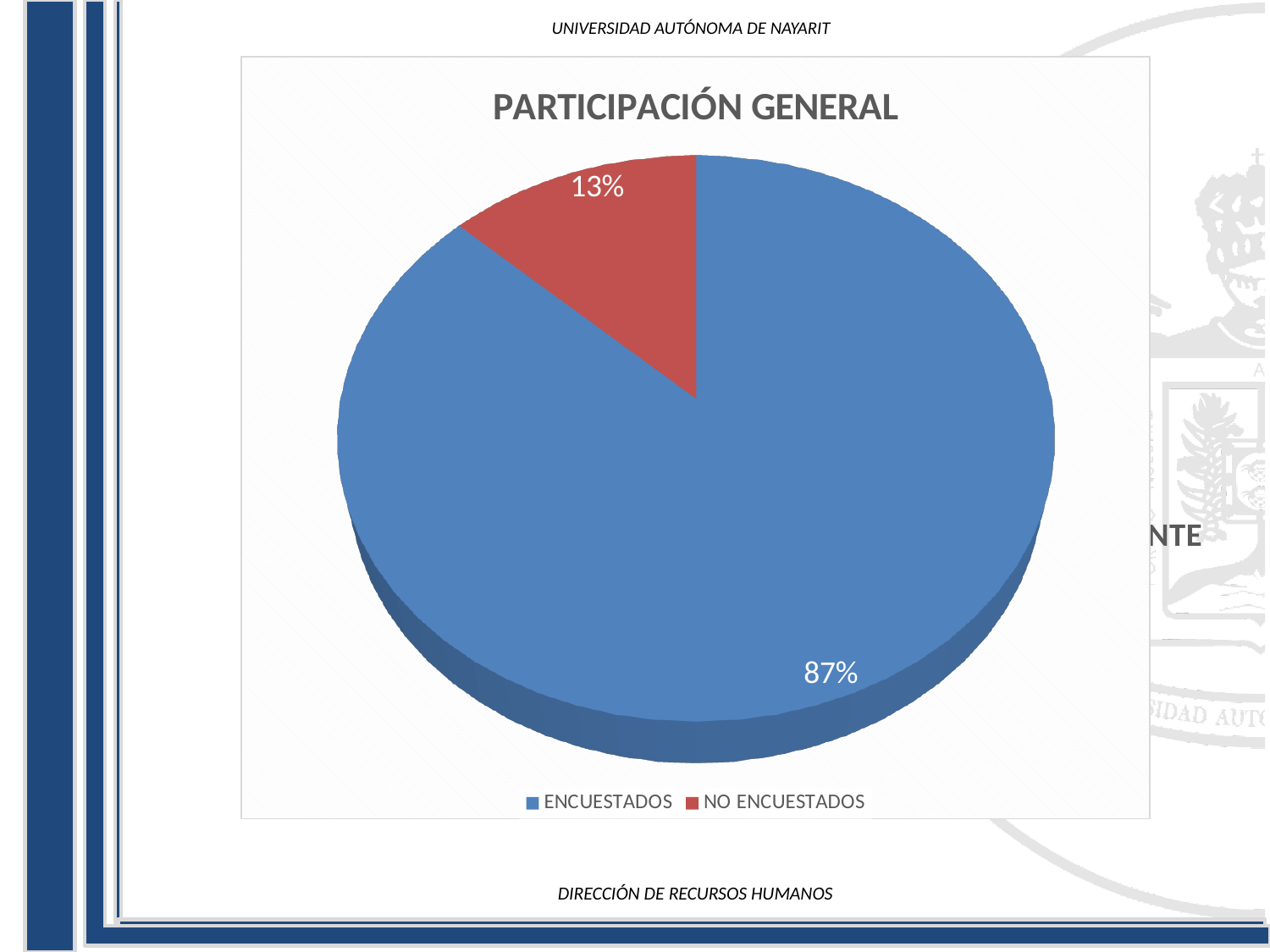
What is the title of the chart? PARTICIPACIÓN GENERAL What colour is the NO ENCUESTADOS slice? red What share of the pie does ENCUESTADOS represent? 87% Which category has the largest slice of the pie? ENCUESTADOS What is the difference in percentage points between ENCUESTADOS and NO ENCUESTADOS? 74 Which category has the smallest slice of the pie? NO ENCUESTADOS How many entries does the legend list? 2 What kind of chart is shown on the slide? pie chart What share of the pie does NO ENCUESTADOS represent? 13% Which is larger, the ENCUESTADOS slice or the NO ENCUESTADOS slice? ENCUESTADOS How many categories does the pie chart show? 2